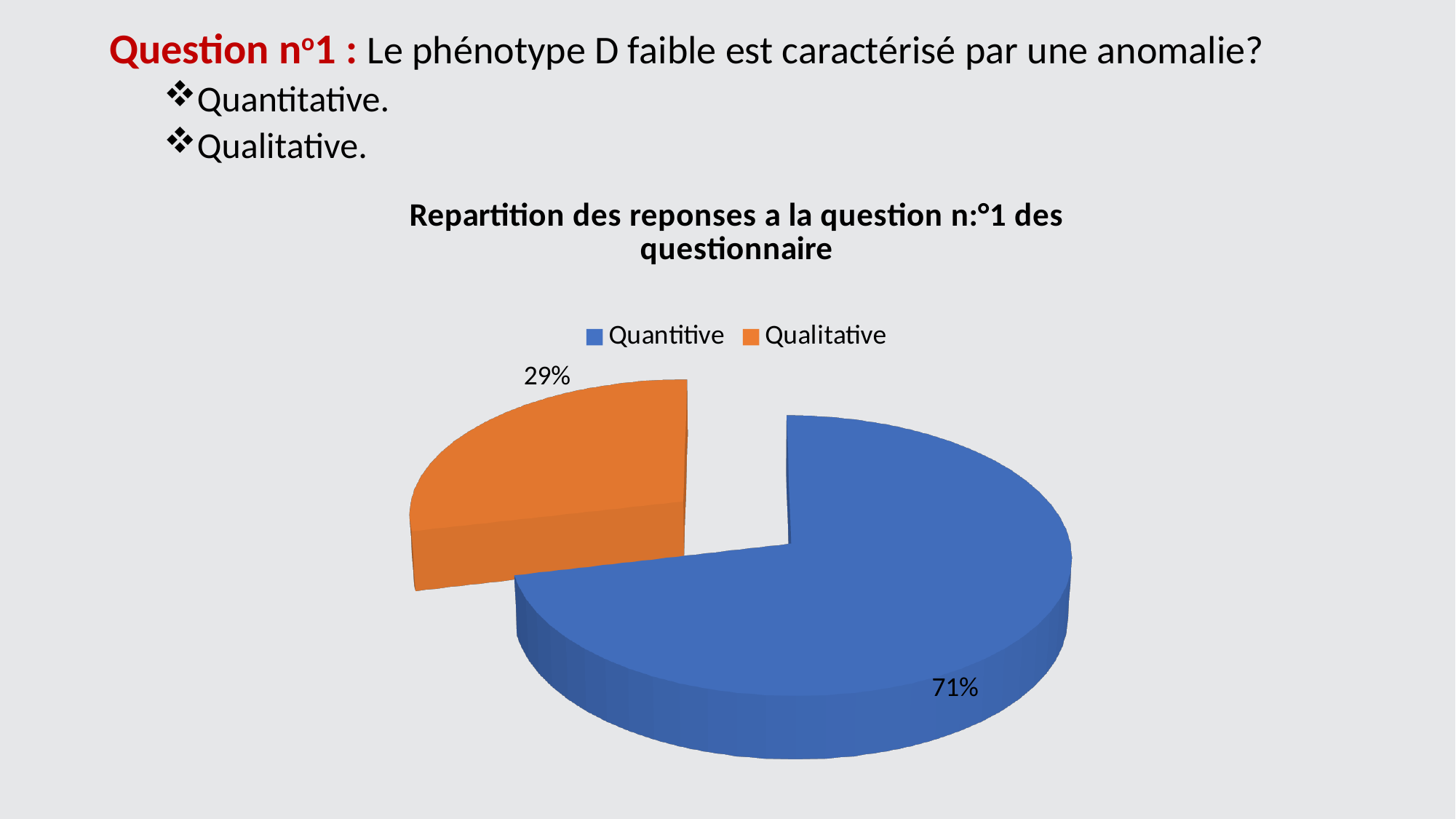
What percentage of responses is labelled for the Qualitative slice? 29% Which is larger, the Quantitive slice or the Qualitative slice? Quantitive What share of the pie does the Qualitative slice represent? 29% What is the difference in percentage points between the Quantitive and Qualitative slices? 42 What percentage of responses is labelled for the Quantitive slice? 71% How many entries does the legend list? 2 Which slice is the largest in the pie chart? Quantitive What kind of chart is shown on the slide? Pie chart Which slice is the smallest in the pie chart? Qualitative How many slices does the pie chart have? 2 What colour is the Qualitative slice? Orange What is the title of the chart? Repartition des reponses a la question n:°1 des questionnaire